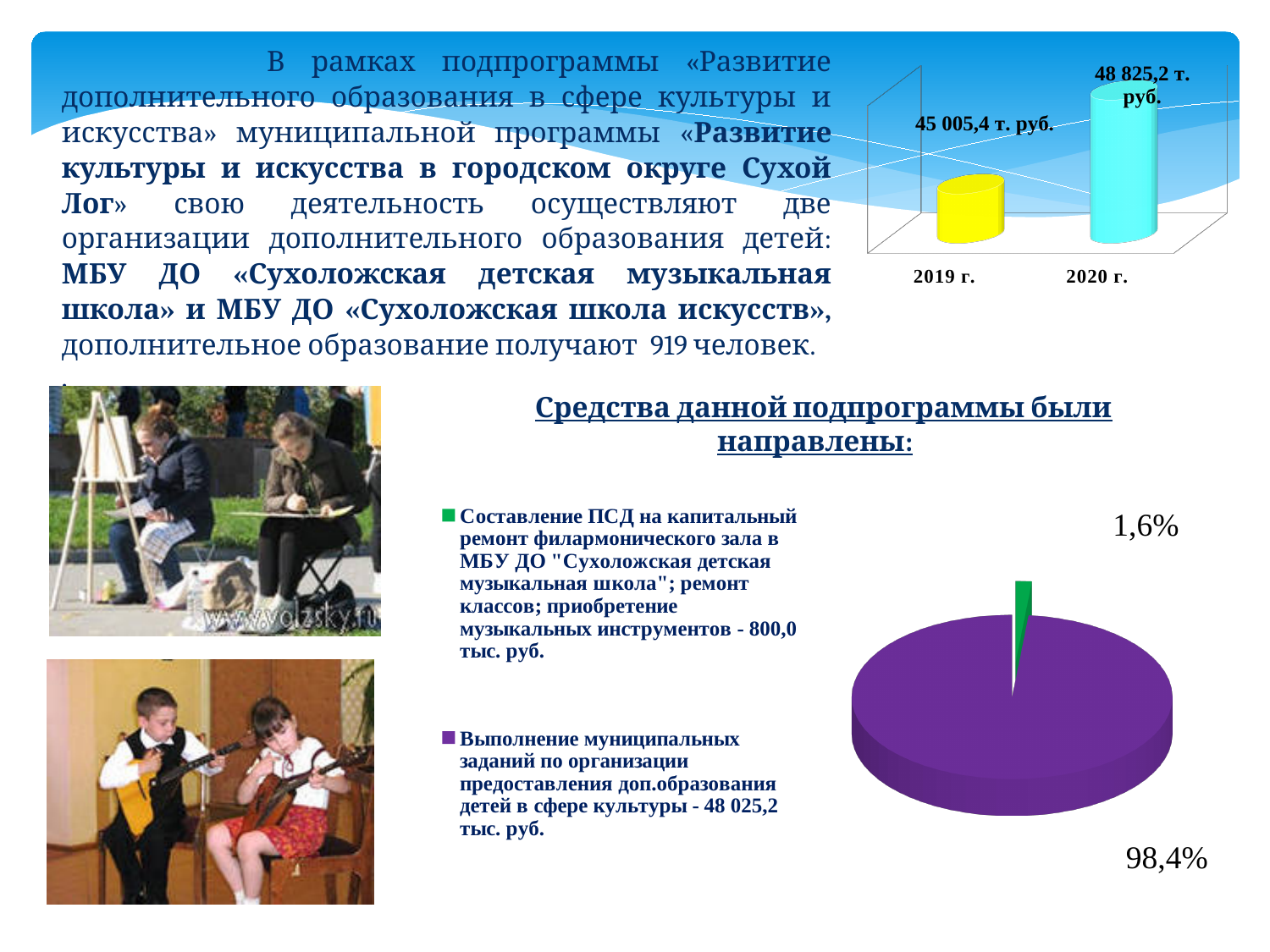
In the bar chart at the top right, how many categories are shown? 2 In the bar chart at the top right, which year has the higher value? 2020 г. What kind of chart is shown at the bottom right of the slide? Pie chart In the bar chart at the top right, what is the value for 2020 г.? 48 825,2 т. руб. What kind of chart is shown at the top right of the slide? Bar chart In the pie chart at the bottom right, what share is shown for 'Выполнение муниципальных заданий по организации предоставления доп.образования детей в сфере культуры'? 98,4% In the bar chart at the top right, do the values rise or fall from 2019 г. to 2020 г.? Rise In the bar chart at the top right, what is the value for 2019 г.? 45 005,4 т. руб. In the bar chart at the top right, by how much does the 2020 г. value exceed the 2019 г. value? 3 819,8 т. руб. In the pie chart at the bottom right, what share is shown for 'Составление ПСД на капитальный ремонт филармонического зала...'? 1,6% In the bar chart at the top right, which year has the lower value? 2019 г. In the pie chart at the bottom right, what colour is the slice representing 98,4%? Purple